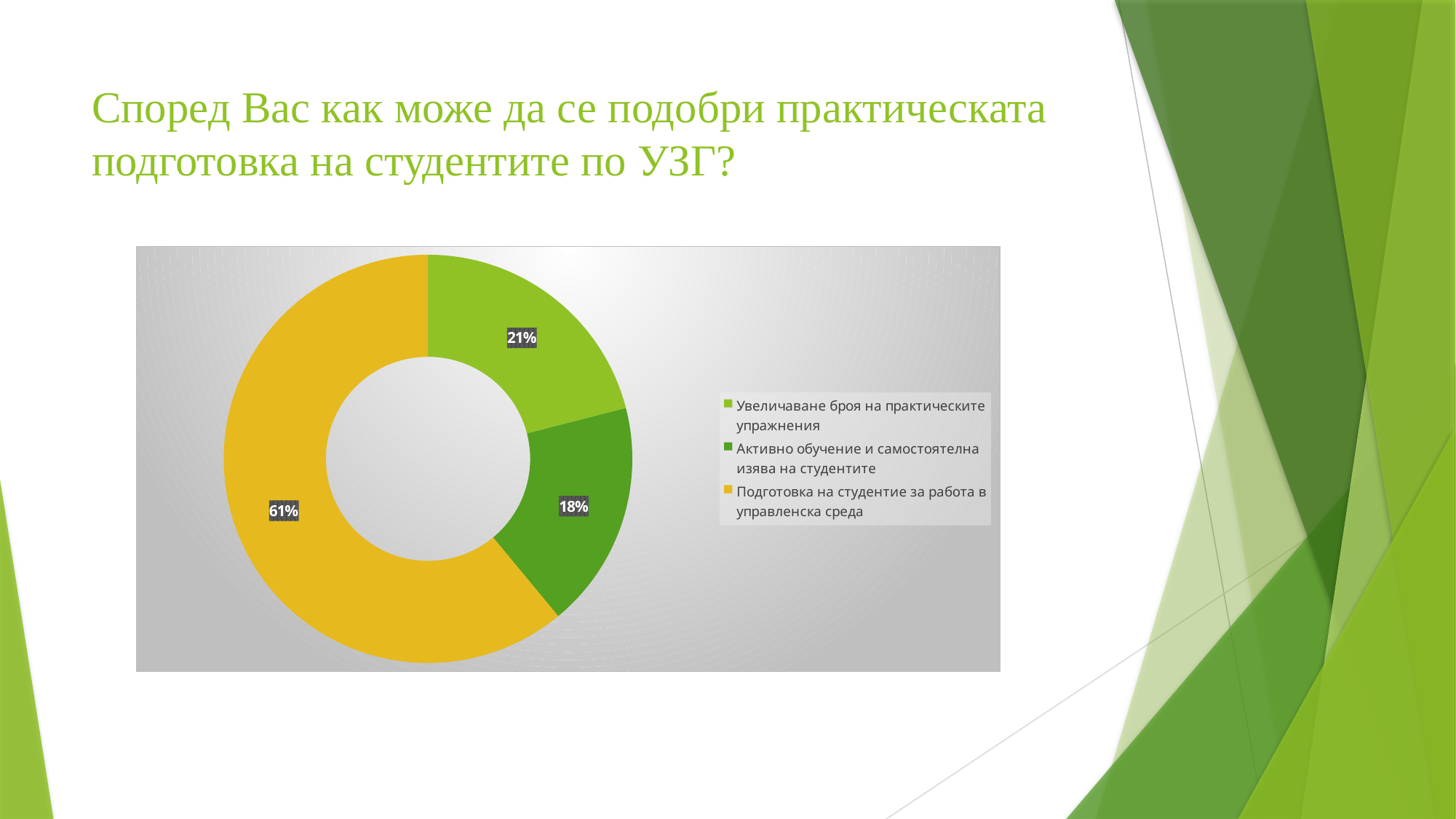
Which category has the smallest share of the chart? Активно обучение и самостоятелна изява на студентите What colour is the slice for "Подготовка на студентие за работа в управленска среда"? Yellow Which is larger: the share for "Увеличаване броя на практическите упражнения" or for "Активно обучение и самостоятелна изява на студентите"? Увеличаване броя на практическите упражнения What is the difference in percentage points between "Увеличаване броя на практическите упражнения" and "Активно обучение и самостоятелна изява на студентите"? 3 What share of the chart does "Увеличаване броя на практическите упражнения" represent? 21% What share of the chart does "Активно обучение и самостоятелна изява на студентите" represent? 18% What is the difference in percentage points between the largest and smallest slices? 43 What share of the chart does "Подготовка на студентие за работа в управленска среда" represent? 61% What is the combined share of the two green slices? 39% Which category has the largest share of the chart? Подготовка на студентие за работа в управленска среда How many categories does the chart show? 3 What kind of chart is shown on the slide? Doughnut (pie) chart